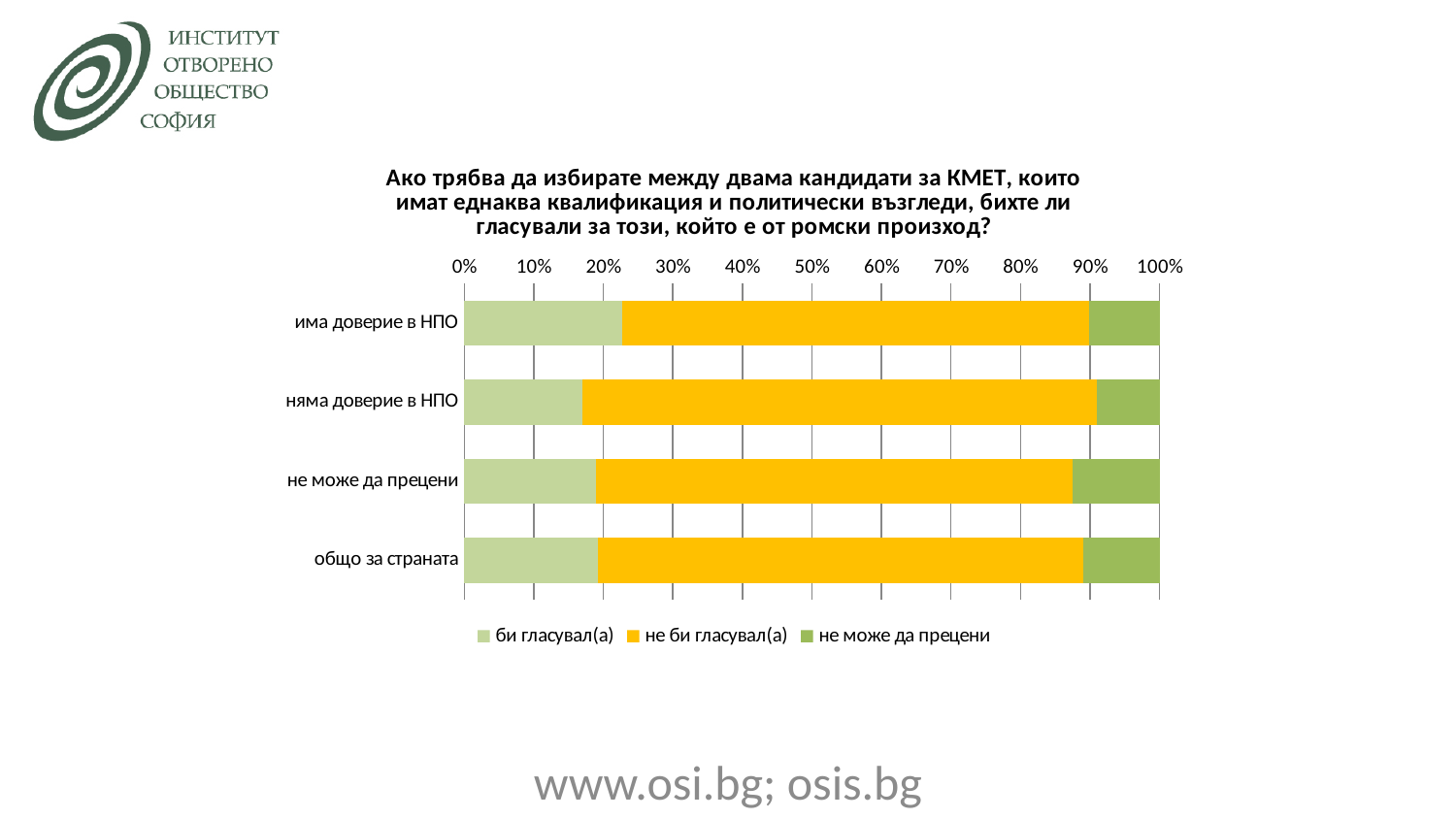
Which category has the largest share for "би гласувал(а)"? има доверие в НПО Which series is shown in orange in the chart? не би гласувал(а) Is the "би гласувал(а)" share for "няма доверие в НПО" greater or less than 20%? less What is the highest value shown on the horizontal axis of the chart? 100% How many categories are shown on the vertical axis of the chart? 4 What kind of chart is shown on the slide? Stacked bar chart Which series takes up the largest portion of every bar in the chart? не би гласувал(а) Which is larger: the "би гласувал(а)" share for "има доверие в НПО" or for "няма доверие в НПО"? има доверие в НПО Which is larger: the "не би гласувал(а)" share for "няма доверие в НПО" or for "има доверие в НПО"? няма доверие в НПО How many series does the chart legend list? 3 Is the "би гласувал(а)" share for "има доверие в НПО" greater or less than 20%? greater